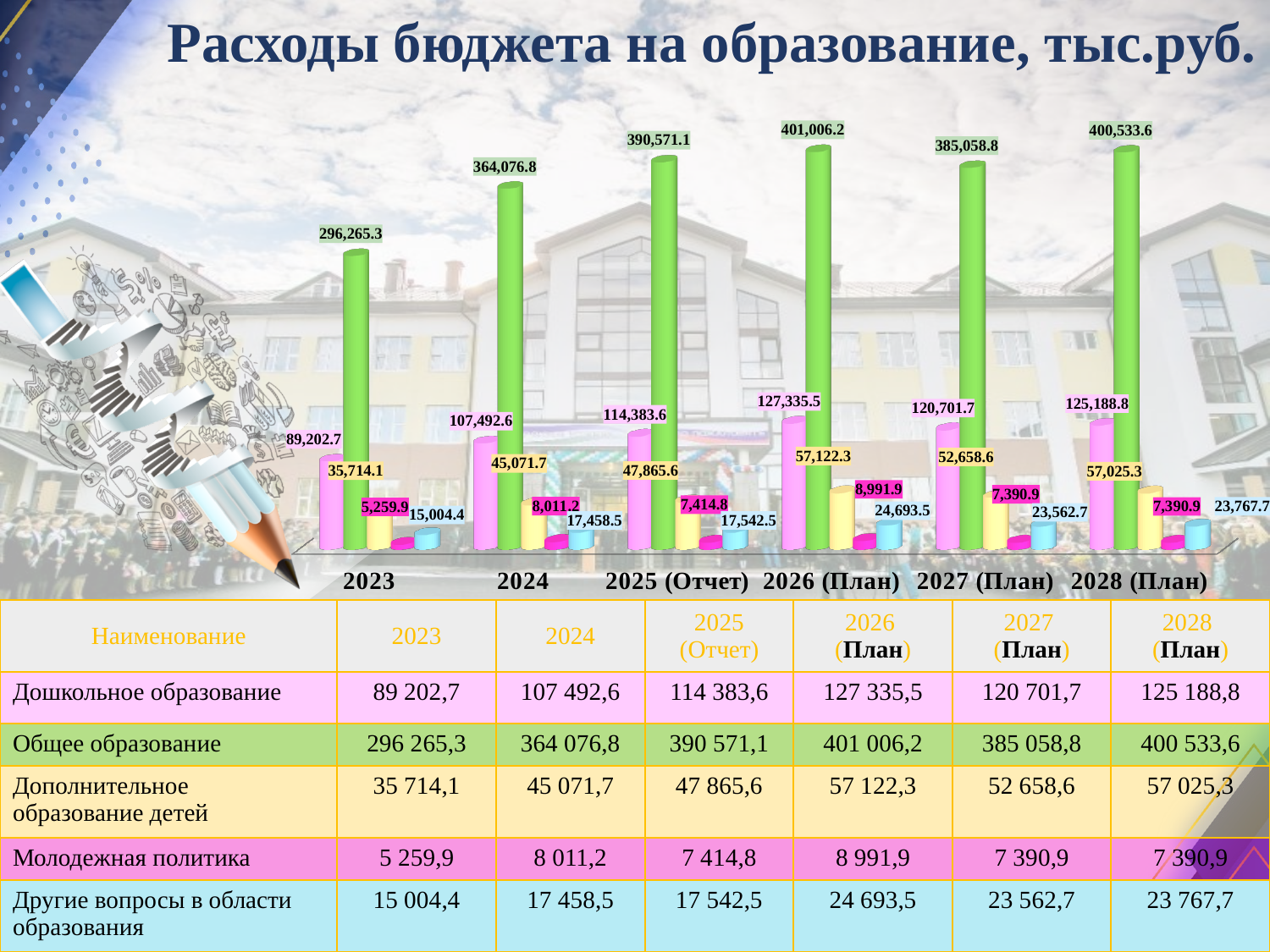
In which year is the value for Общее образование the highest? 2026 (План) What is the difference between Дополнительное образование детей in 2026 (План) and in 2025 (Отчет)? 9,256.7 Which is larger for Дошкольное образование: 2027 (План) or 2028 (План)? 2028 (План) Does the value for Общее образование rise or fall from 2023 to 2025 (Отчет)? Rise What is the value for Другие вопросы в области образования in 2026 (План)? 24,693.5 How many data series are plotted in the chart? 5 By how much does Общее образование in 2024 exceed Общее образование in 2023? 67,811.5 How many year categories are shown on the x axis of the chart? 6 In which year is the value for Молодежная политика the lowest? 2023 What is the value for Общее образование in 2023? 296,265.3 What is the value for Дошкольное образование in 2026 (План)? 127,335.5 What kind of chart is shown on the slide? Bar chart